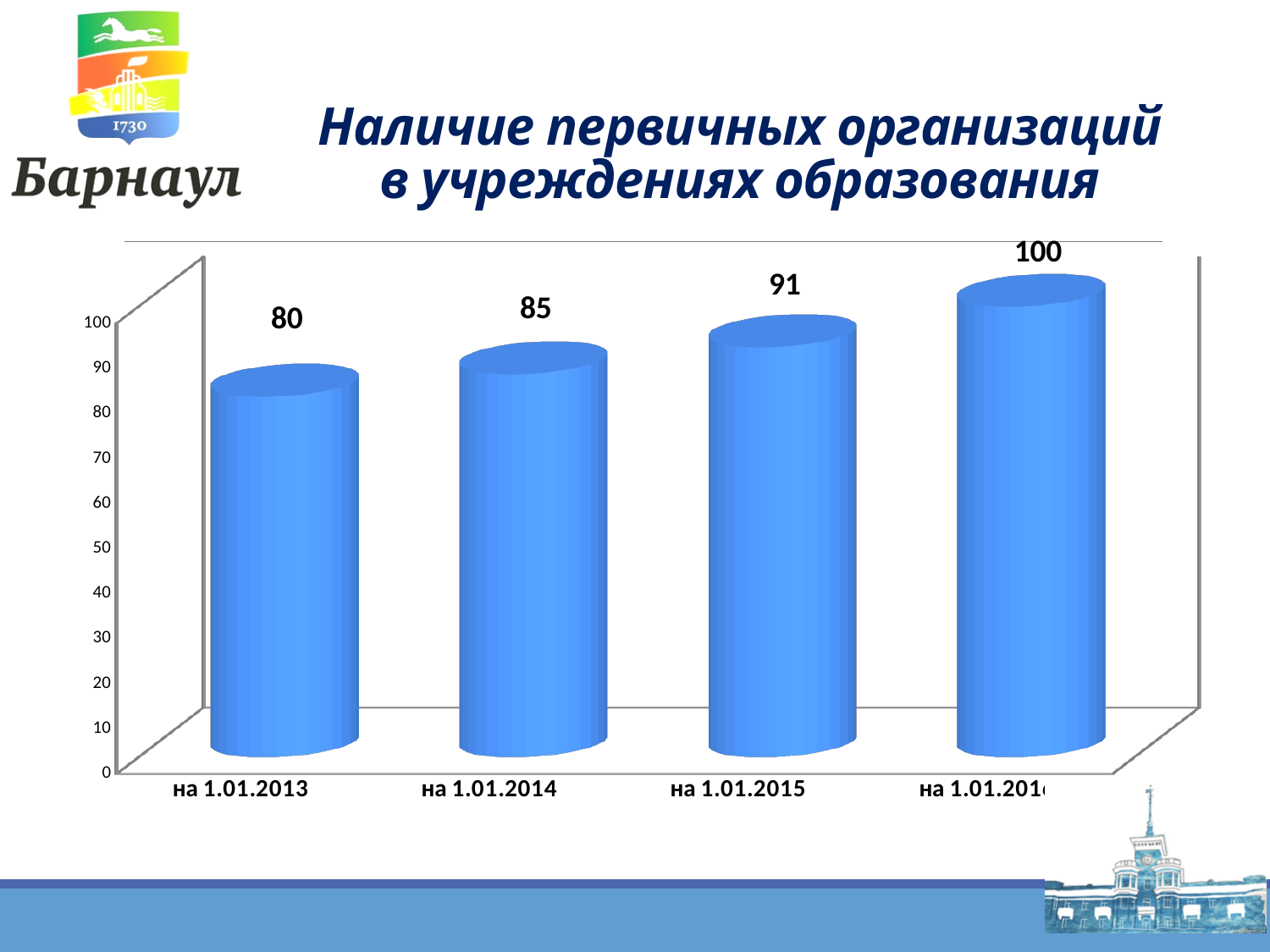
What is the difference between the values for на 1.01.2015 and на 1.01.2013? 11 Which category has the lowest value? на 1.01.2013 What is the value for на 1.01.2014? 85 What is the value shown on the rightmost bar? 100 What is the difference between the values for на 1.01.2014 and на 1.01.2013? 5 What kind of chart is shown on the slide? bar chart What is the value for на 1.01.2015? 91 Do the values rise or fall from left to right along the x axis? rise Which is larger, the value for на 1.01.2014 or the value for на 1.01.2015? на 1.01.2015 How many bars are shown in the chart? 4 Which bar has the highest value? the rightmost bar (на 1.01.2016) What is the value for на 1.01.2013? 80